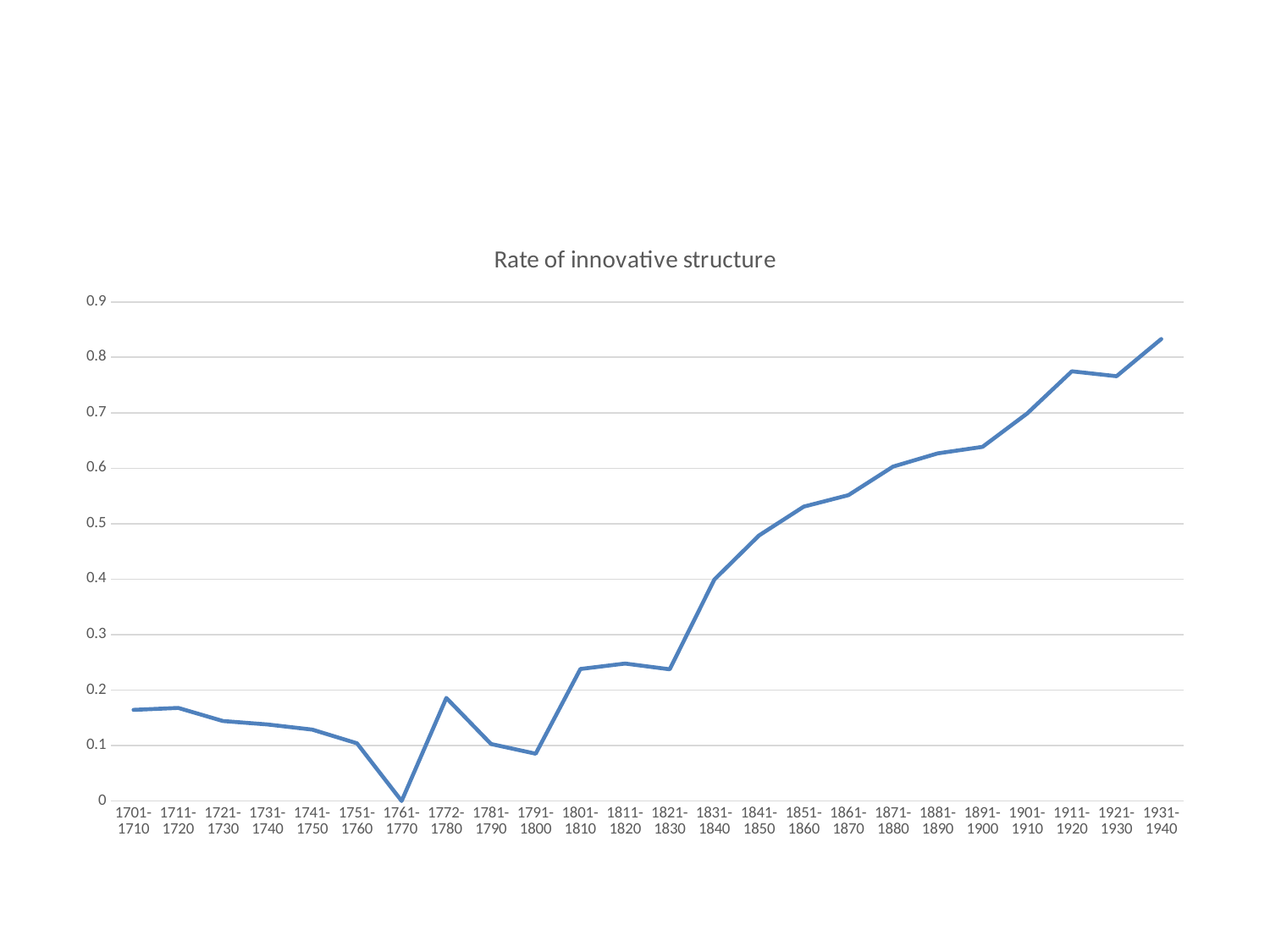
Which period has the highest rate of innovative structure? 1931-1940 Is the value for 1901-1910 greater or less than 0.6? greater Which period has the lowest rate of innovative structure? 1761-1770 What is the value for 1761-1770? 0 How many time periods are plotted along the x axis? 24 Which period has the larger value, 1821-1830 or 1831-1840? 1831-1840 Which period has the larger value, 1772-1780 or 1781-1790? 1772-1780 What kind of chart is shown on the slide? line chart Is the value for 1831-1840 greater or less than 0.3? greater What is the title of the chart? Rate of innovative structure Is the value for 1701-1710 greater or less than 0.2? less Does the rate of innovative structure rise or fall from 1801-1810 to 1931-1940? rise